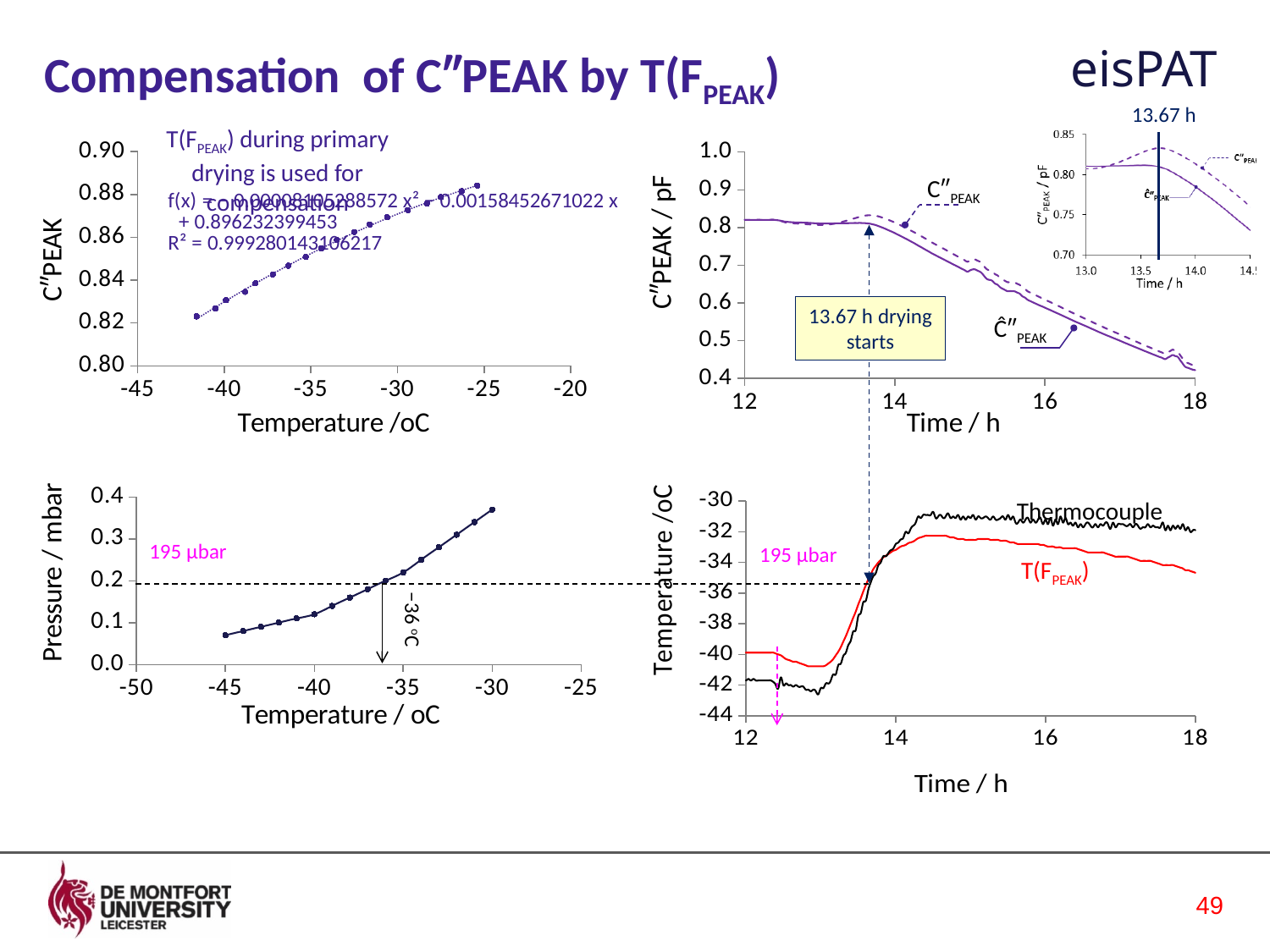
In the top-left chart, do the C″PEAK values rise or fall as temperature increases from -45 to -20 °C? rise In the bottom-left chart of Pressure / mbar against Temperature / oC, is the pressure at -45 °C greater or less than 0.1? less In the top-left chart, what R² value is printed for the fitted trend line? 0.999280143106217 In the bottom-right chart of Temperature /oC against Time / h, how many series are labelled? 2 In the bottom-right chart, which series is higher at 18 h, Thermocouple or T(FPEAK)? Thermocouple In the top-right chart, is the value of C″PEAK at 12 h greater or less than 0.7? greater In the top-right chart, at what time does the annotation say drying starts? 13.67 h In the top-right chart, do the C″PEAK values rise or fall between 14 h and 18 h? fall In the bottom-left chart, is the pressure at -30 °C greater or less than 0.3? greater In the top-right chart of C″PEAK / pF against Time / h, how many data series are plotted? 2 What kind of chart is the top-left chart of C″PEAK against Temperature? scatter chart